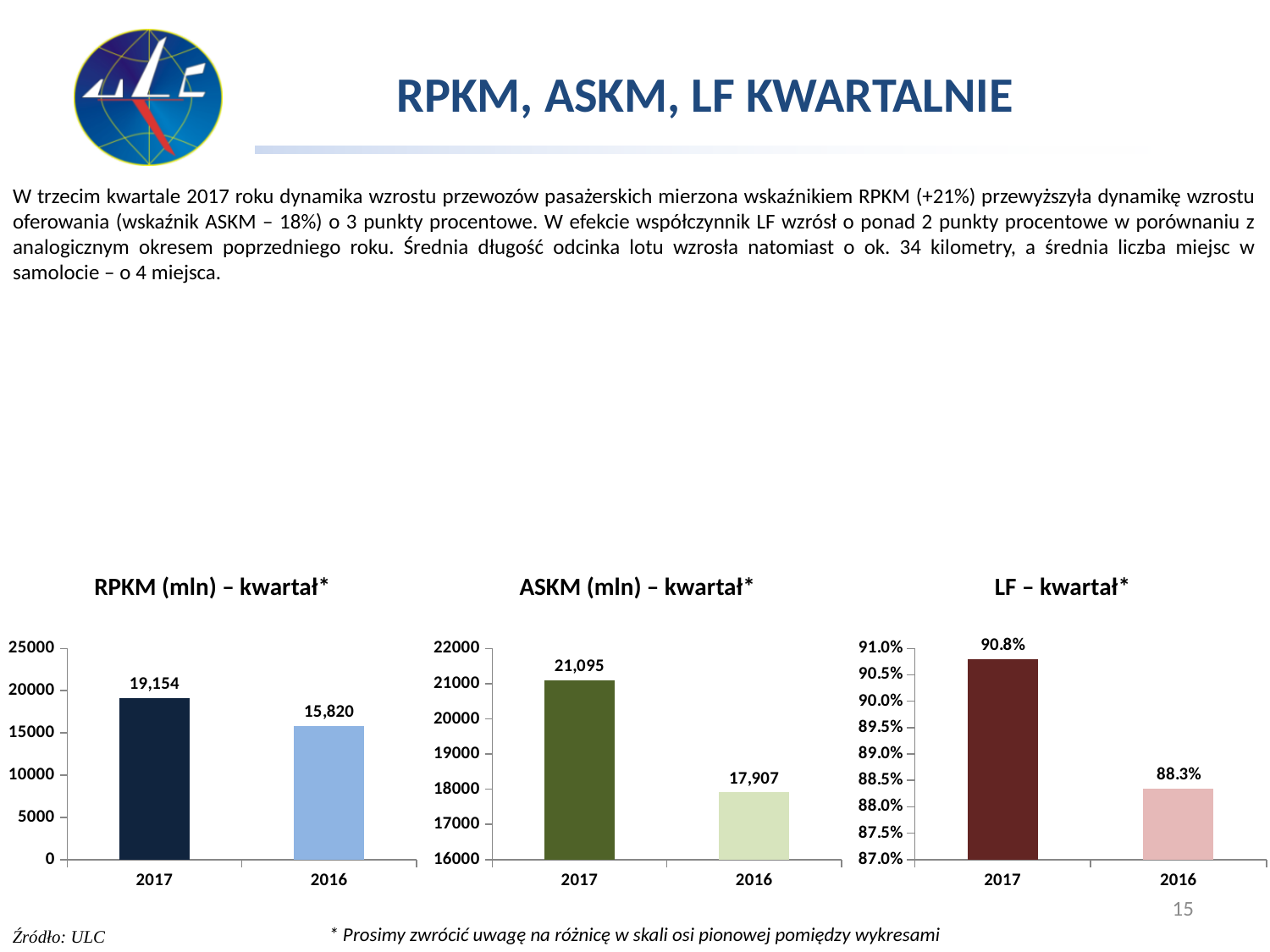
In the RPKM (mln) – kwartał* chart, what is the value for 2017? 19,154 In the ASKM (mln) – kwartał* chart, what is the value for 2017? 21,095 In the ASKM (mln) – kwartał* chart, what is the difference between the 2017 and 2016 values? 3,188 What type of chart is the LF – kwartał* chart? bar chart In the LF – kwartał* chart, which year has the higher value? 2017 How many bars are shown in the RPKM (mln) – kwartał* chart? 2 In the ASKM (mln) – kwartał* chart, is the value for 2016 greater or less than 18000? less In the LF – kwartał* chart, what is the value for 2016? 88.3% In the ASKM (mln) – kwartał* chart, what is the value for 2016? 17,907 In the RPKM (mln) – kwartał* chart, what is the difference between the 2017 and 2016 values? 3,334 In the LF – kwartał* chart, what is the value for 2017? 90.8% In the RPKM (mln) – kwartał* chart, what is the value for 2016? 15,820